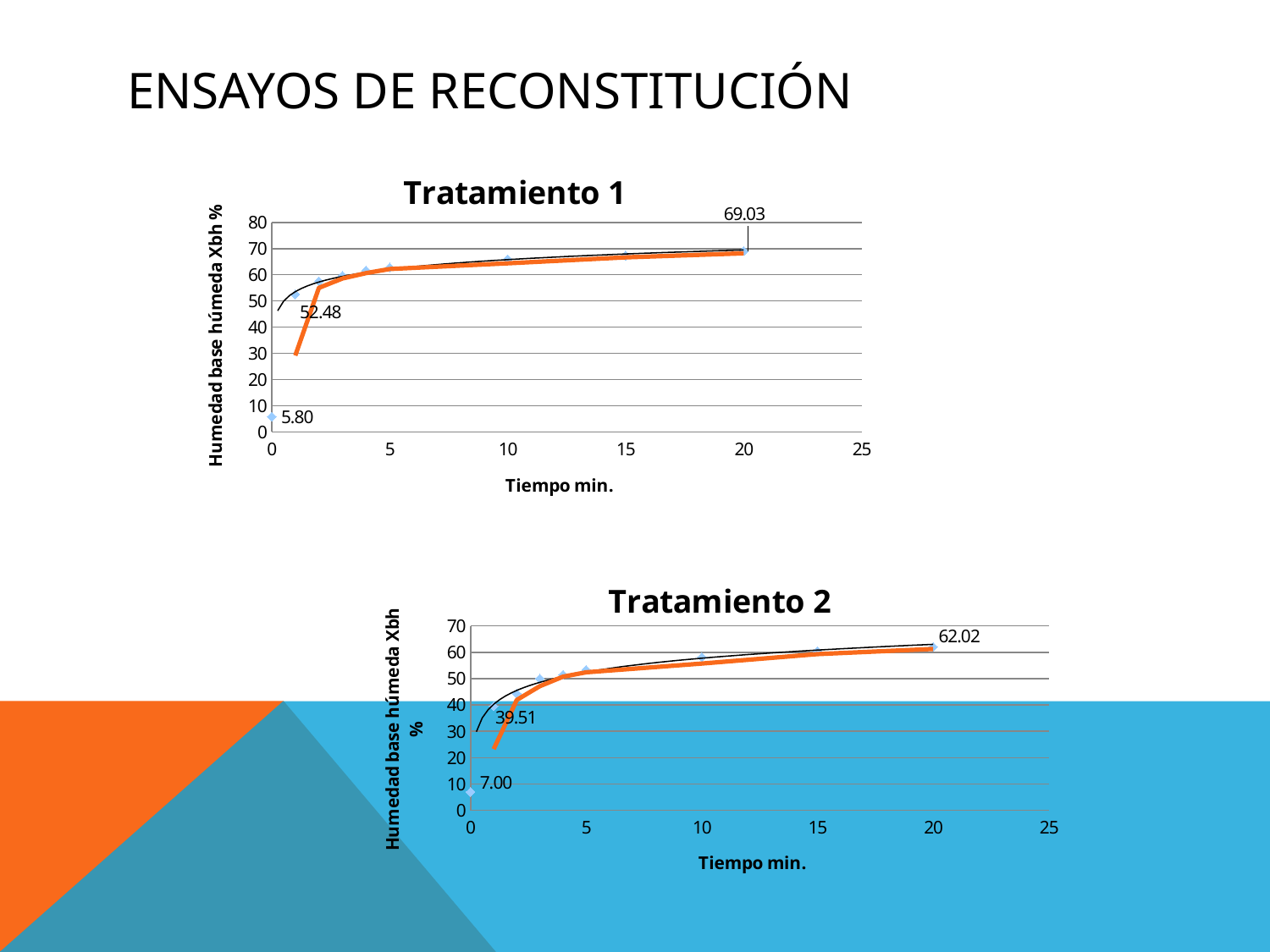
Which chart has the higher labelled value at 20 minutes, Tratamiento 1 or Tratamiento 2? Tratamiento 1 In the Tratamiento 1 chart, does the humidity rise or fall as time increases? rise In the Tratamiento 1 chart, what is the labelled value at 20 minutes? 69.03 What is the x-axis title of the Tratamiento 2 chart? Tiempo min. In the Tratamiento 2 chart, what is the difference between the labelled values at 20 minutes and at 1 minute? 22.51 In the Tratamiento 2 chart, is the value at 10 minutes greater or less than 50? greater In the Tratamiento 1 chart, what is the labelled value at time 0? 5.80 In the Tratamiento 2 chart, what is the labelled value at 1 minute? 39.51 In the Tratamiento 1 chart, what is the difference between the labelled values at 20 minutes and at time 0? 63.23 In the Tratamiento 1 chart, what is the labelled value at 1 minute? 52.48 In the Tratamiento 2 chart, what is the labelled value at 20 minutes? 62.02 In the Tratamiento 2 chart, what is the labelled value at time 0? 7.00